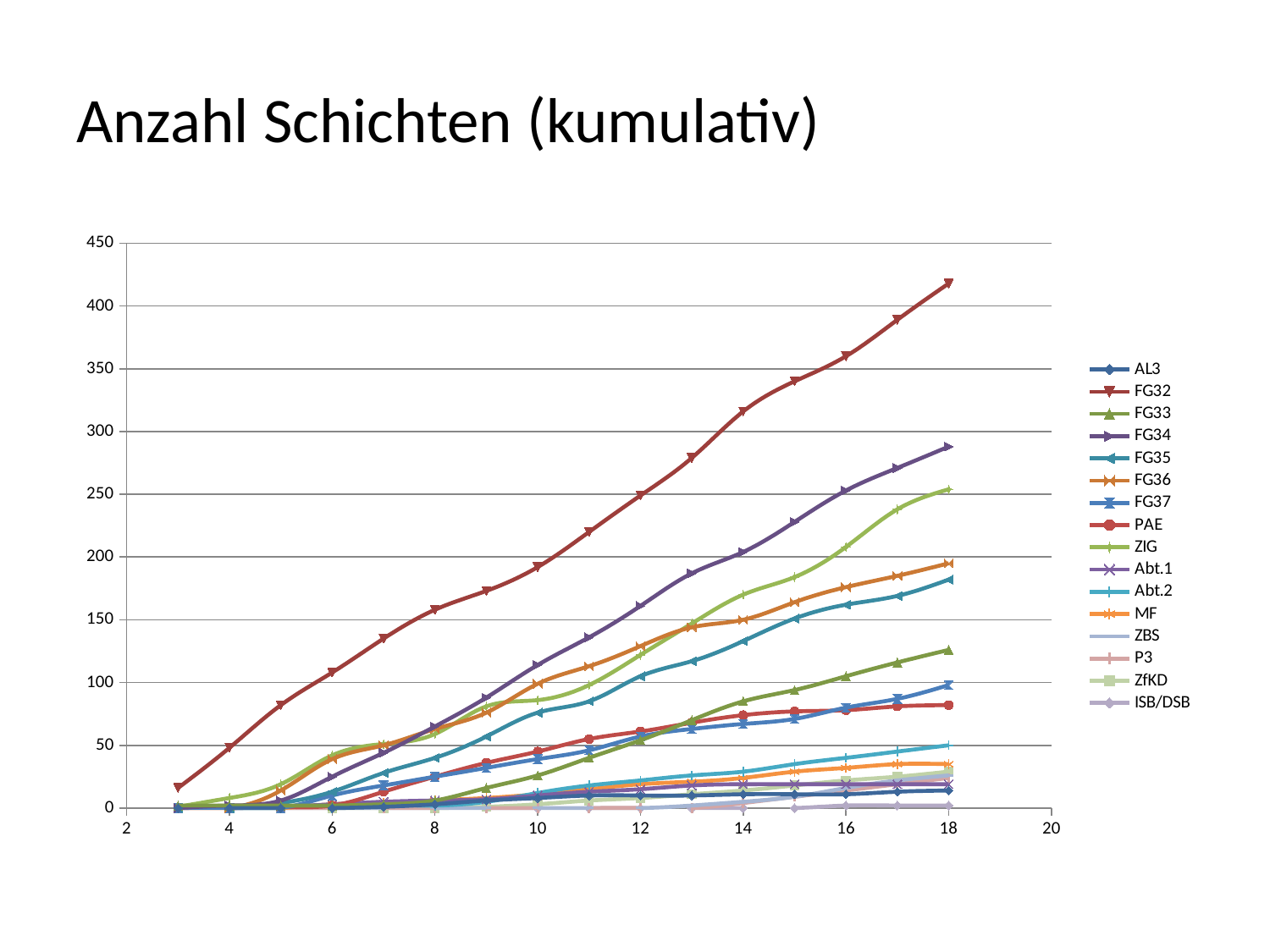
At x = 18, which series has the larger value, FG34 or ZIG? FG34 Is the value for FG34 at x = 18 greater or less than 250? greater Is the value for FG32 at x = 18 greater or less than 400? greater Is the value for PAE at x = 18 greater or less than 100? less How many series does the legend list? 16 At x = 18, which series has the larger value, FG37 or PAE? FG37 Which series has the highest value at x = 18? FG32 What kind of chart is shown on the slide? line chart Do the values for FG32 rise or fall as x increases? rise What is the title of the chart? Anzahl Schichten (kumulativ)